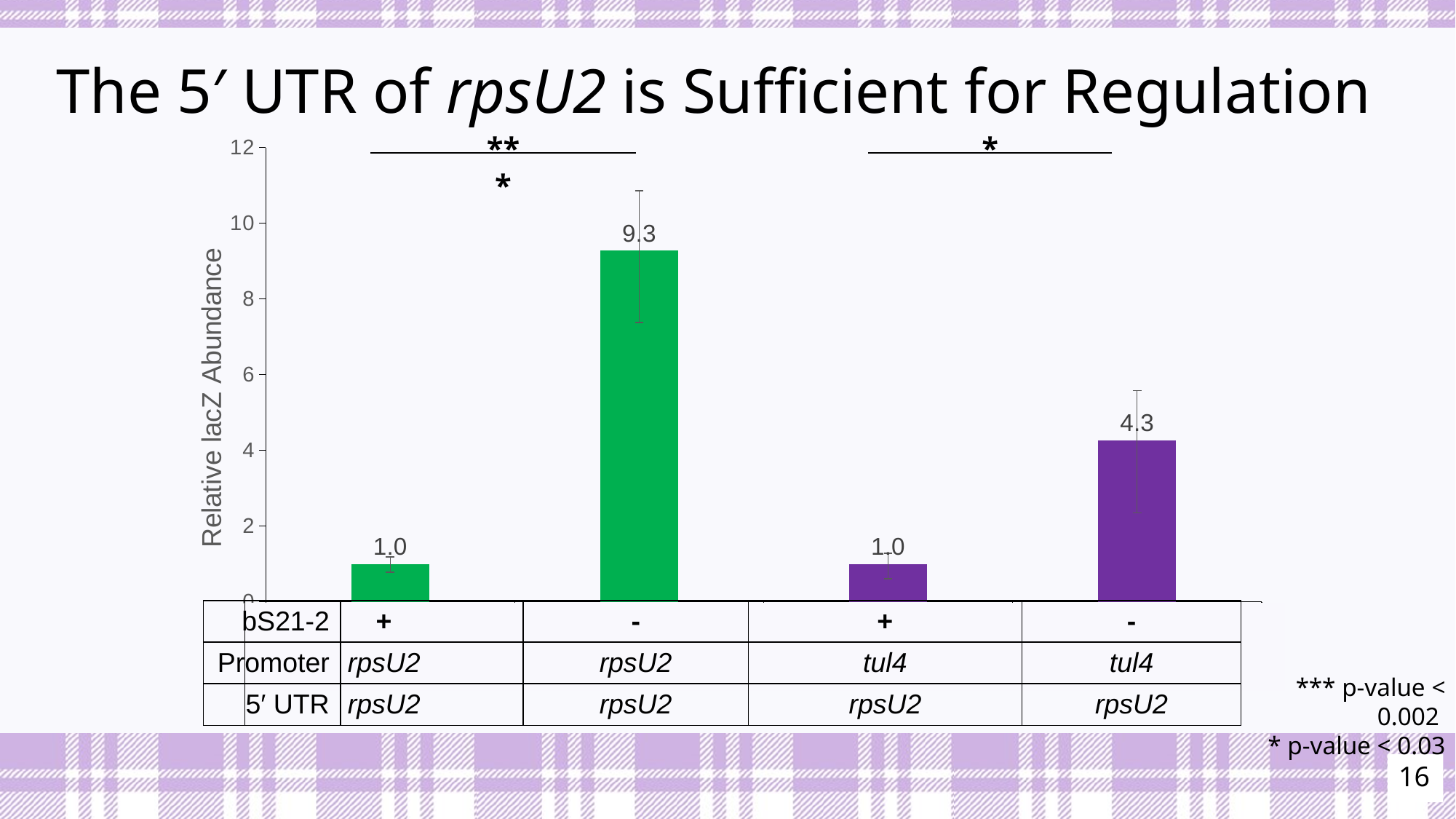
What is the relative lacZ abundance for the tul4 promoter with bS21-2 present (+)? 1.0 Which is larger: the relative lacZ abundance for rpsU2 promoter with bS21-2 - or for tul4 promoter with bS21-2 -? rpsU2 promoter with bS21-2 - What is the difference in relative lacZ abundance between the rpsU2 promoter bS21-2 - bar and the tul4 promoter bS21-2 - bar? 5.0 How many bars are plotted in the chart? 4 What is the relative lacZ abundance for the rpsU2 promoter with bS21-2 absent (-)? 9.3 What type of chart is shown on the slide? bar chart What is the label of the y-axis? Relative lacZ Abundance What is the difference in relative lacZ abundance between the rpsU2 promoter bS21-2 - bar and the rpsU2 promoter bS21-2 + bar? 8.3 Which condition has the highest relative lacZ abundance? rpsU2 promoter, bS21-2 - What colour are the bars for the tul4 promoter? purple Is the relative lacZ abundance for the tul4 promoter with bS21-2 - greater or less than 6? less What is the relative lacZ abundance for the tul4 promoter with bS21-2 absent (-)? 4.3